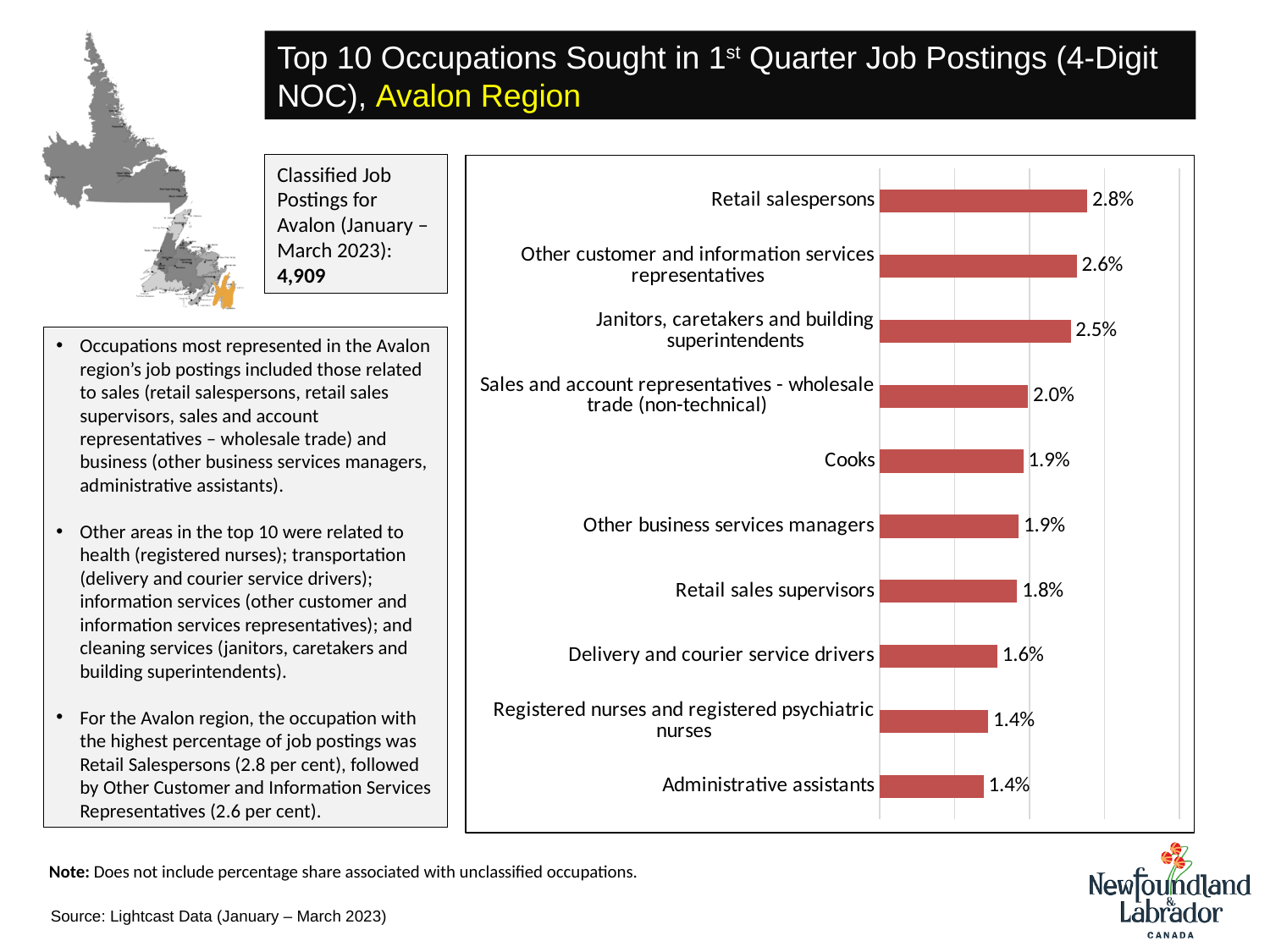
What is the value shown for Janitors, caretakers and building superintendents? 2.5% What is the value shown for Cooks? 1.9% Which is larger, the value for Retail sales supervisors or the value for Delivery and courier service drivers? Retail sales supervisors What colour are the bars in the chart? Red Do the values rise or fall going from the top bar to the bottom bar? Fall What is the difference between the values for Retail salespersons and Other customer and information services representatives? 0.2% What kind of chart is shown on the slide? Bar chart What is the difference between the values for Sales and account representatives - wholesale trade (non-technical) and Administrative assistants? 0.6% Which occupation has the highest percentage in the chart? Retail salespersons How many occupations are shown in the chart? 10 What percentage of job postings is shown for Retail salespersons? 2.8% What is the value shown for Delivery and courier service drivers? 1.6%